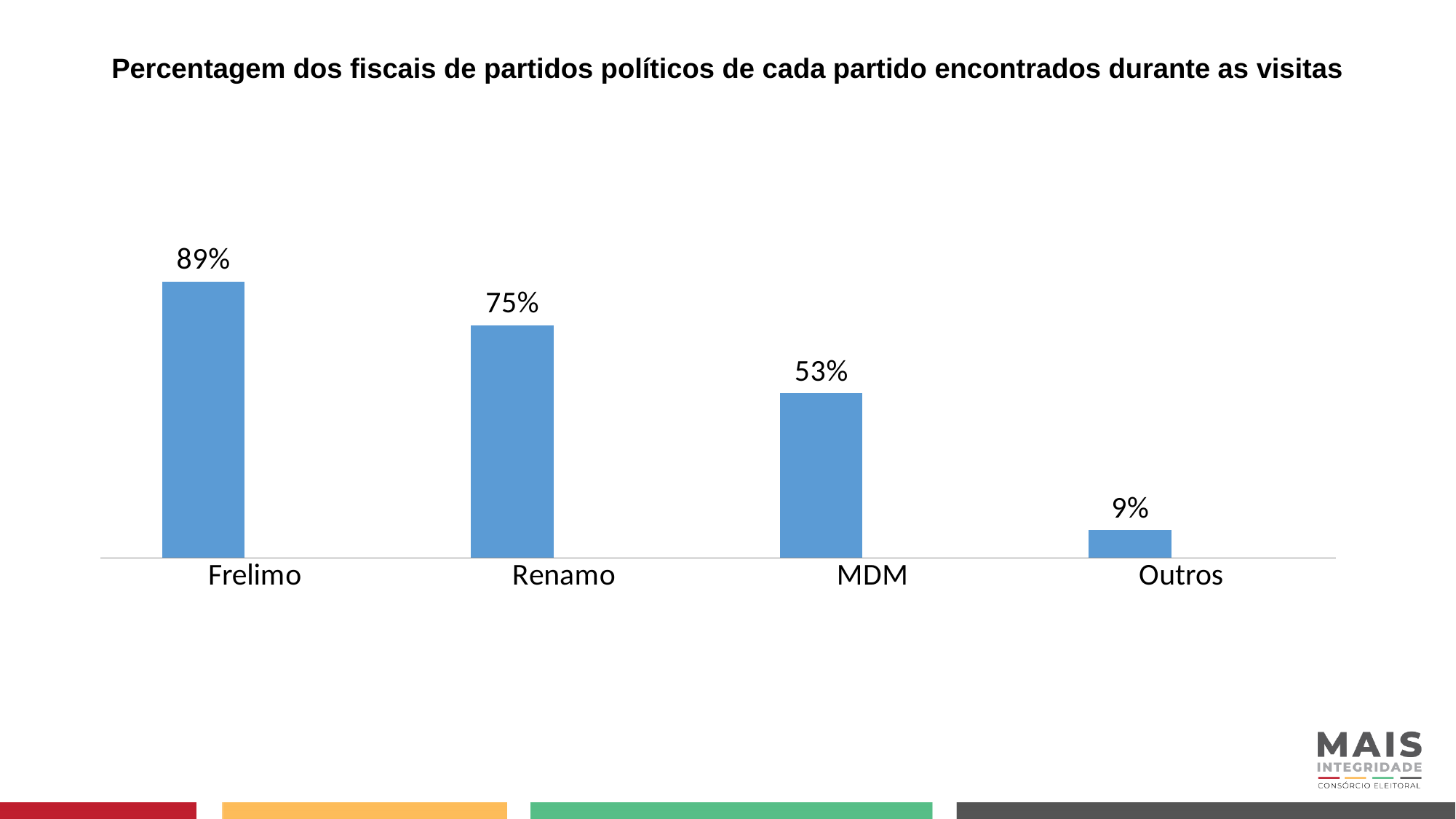
Do the values rise or fall from left to right along the x axis? Fall Which category has the lowest percentage? Outros What is the difference between the values for Frelimo and Renamo? 14% How many categories are shown in the chart? 4 What kind of chart is shown on the slide? Bar chart What is the difference between the values for MDM and Outros? 44% Which party has the highest percentage? Frelimo What is the value for Renamo? 75% Which is larger, the value for Renamo or the value for MDM? Renamo What is the value for Outros? 9% What is the value for MDM? 53% What is the value for Frelimo? 89%